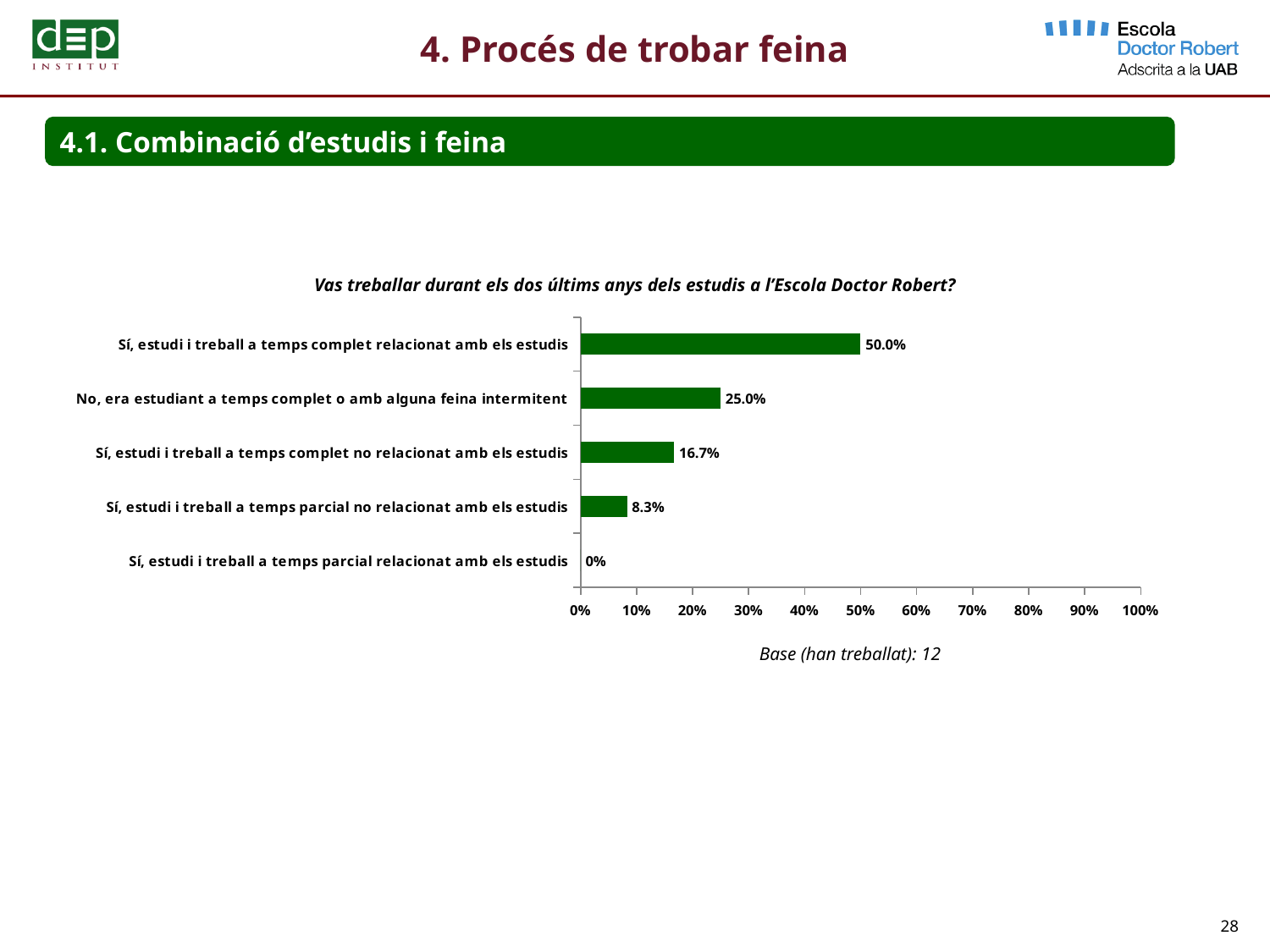
What is the value for "Sí, estudi i treball a temps parcial no relacionat amb els estudis"? 8.3% What is the base (number of respondents) stated below the chart? 12 Is the value for "Sí, estudi i treball a temps complet no relacionat amb els estudis" greater or less than 20%? less What is the difference between the values for "Sí, estudi i treball a temps complet relacionat amb els estudis" and "No, era estudiant a temps complet o amb alguna feina intermitent"? 25.0% Which is larger: the value for "Sí, estudi i treball a temps complet no relacionat amb els estudis" or for "Sí, estudi i treball a temps parcial no relacionat amb els estudis"? Sí, estudi i treball a temps complet no relacionat amb els estudis Which category has the lowest value? Sí, estudi i treball a temps parcial relacionat amb els estudis How many categories are shown in the chart? 5 What is the value for "No, era estudiant a temps complet o amb alguna feina intermitent"? 25.0% What is the value for "Sí, estudi i treball a temps complet relacionat amb els estudis"? 50.0% What is the value for "Sí, estudi i treball a temps parcial relacionat amb els estudis"? 0% Which category has the highest value? Sí, estudi i treball a temps complet relacionat amb els estudis What kind of chart is shown on the slide? bar chart